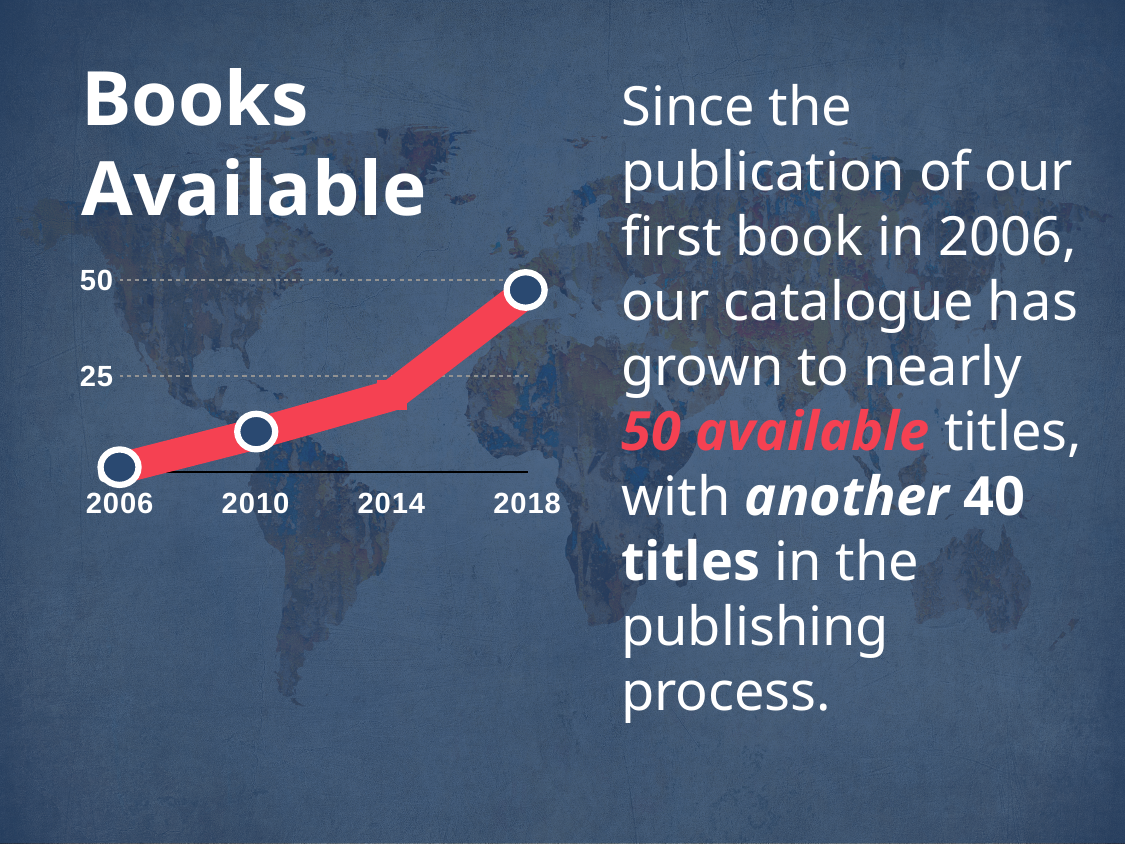
What is the title of the chart? Books Available Which is larger, the value for 2018 or the value for 2010? 2018 Which year has the lowest value in the chart? 2006 What kind of chart is shown on the slide? line chart How many years are labelled on the x axis of the chart? 4 Is the value for 2018 greater or less than 25? greater Is the value for 2006 greater or less than 25? less Is the value for 2010 greater or less than 25? less Which year has the highest value in the chart? 2018 What colour is the line in the chart? red Do the values rise or fall from 2006 to 2018? rise